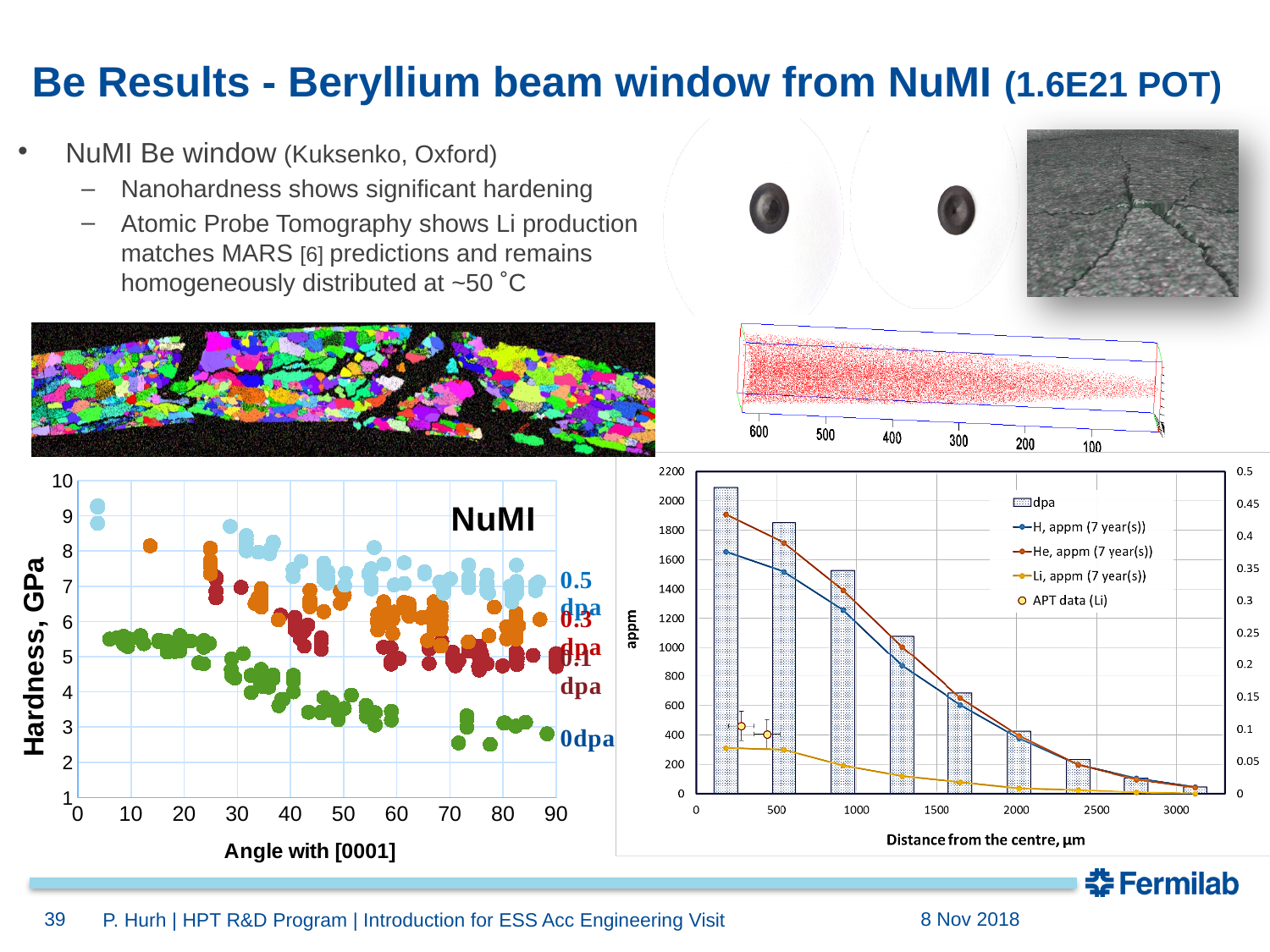
On the left chart, is the hardness of the 0.5 dpa series at an angle of 30 greater or less than 6 GPa? greater On the right chart, which line series has the lowest appm values? Li, appm (7 year(s)) On the left chart, which dpa series shows the lowest hardness values? 0dpa On the left chart, which dpa series shows the highest hardness values? 0.5 dpa On the right chart, how many dpa bars are plotted? 9 On the right chart, do the dpa bars rise or fall as distance from the centre increases? fall What kind of chart is the left chart (Hardness vs Angle with [0001])? scatter chart On the right chart, what is the x-axis title? Distance from the centre, µm On the left chart, what is the x-axis title? Angle with [0001] On the left chart, do the 0dpa hardness values rise or fall as the angle increases? fall On the left chart, how many dpa levels are labelled? 4 On the right chart, how many series does the legend list? 5